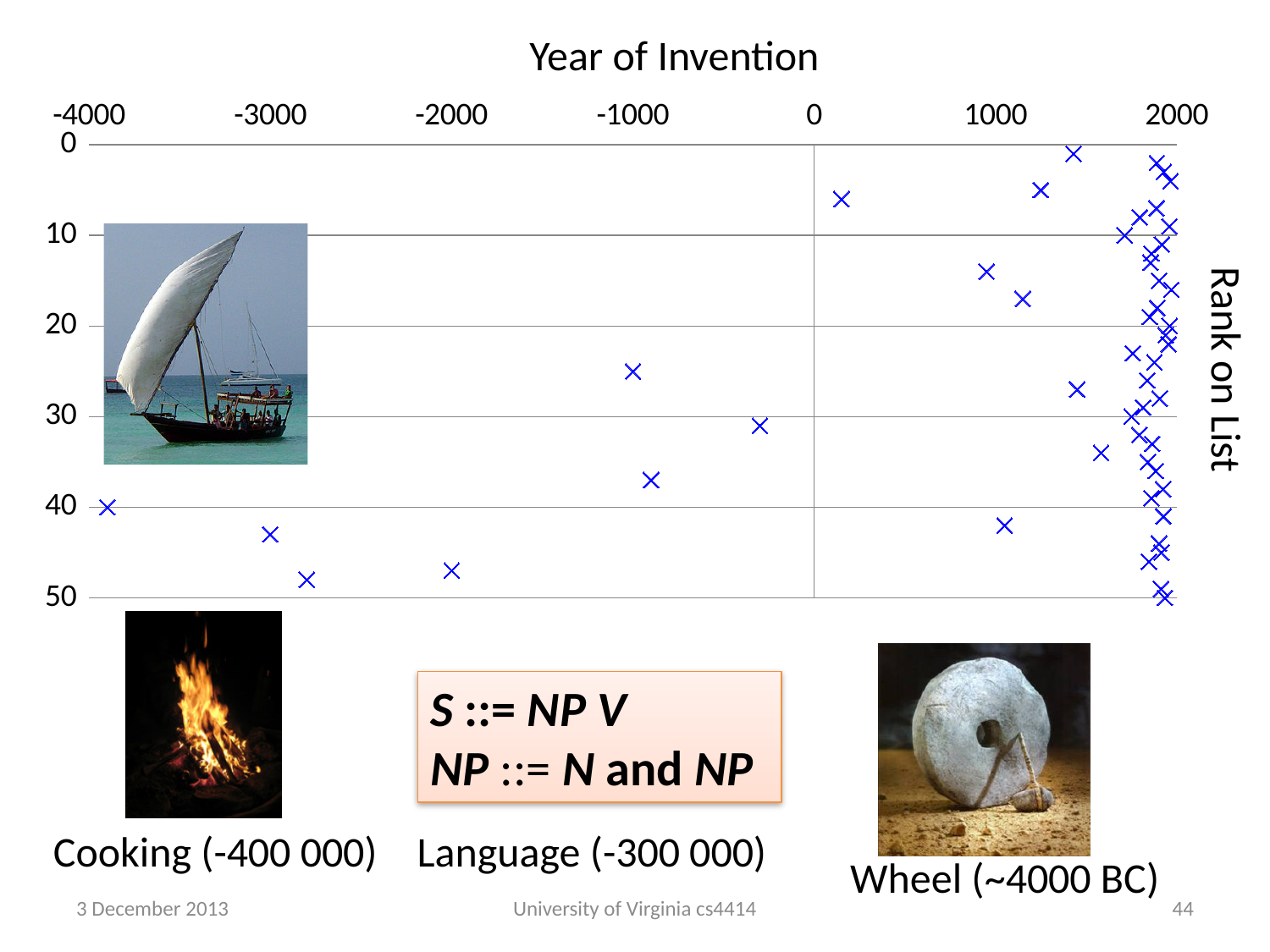
What is the title of the horizontal axis of the chart? Year of Invention What kind of chart is shown on the slide? scatter chart What is the smallest value shown on the horizontal axis of the chart? -4000 What is the largest value shown on the horizontal axis of the chart? 2000 Is the rank of the point plotted just after year 0 greater or less than 10? less Which side of year 0 has more plotted points, the left or the right? right How many data points are plotted to the left of year -2500 on the chart? 3 What is the title of the vertical axis of the chart? Rank on List Is the rank of the point plotted near year -2000 greater or less than 40? greater Is the rank of the leftmost point on the chart (near year -4000) greater or less than 30? greater What is the largest rank value shown on the vertical axis of the chart? 50 How many data points are plotted to the left of year 0 on the chart? 7